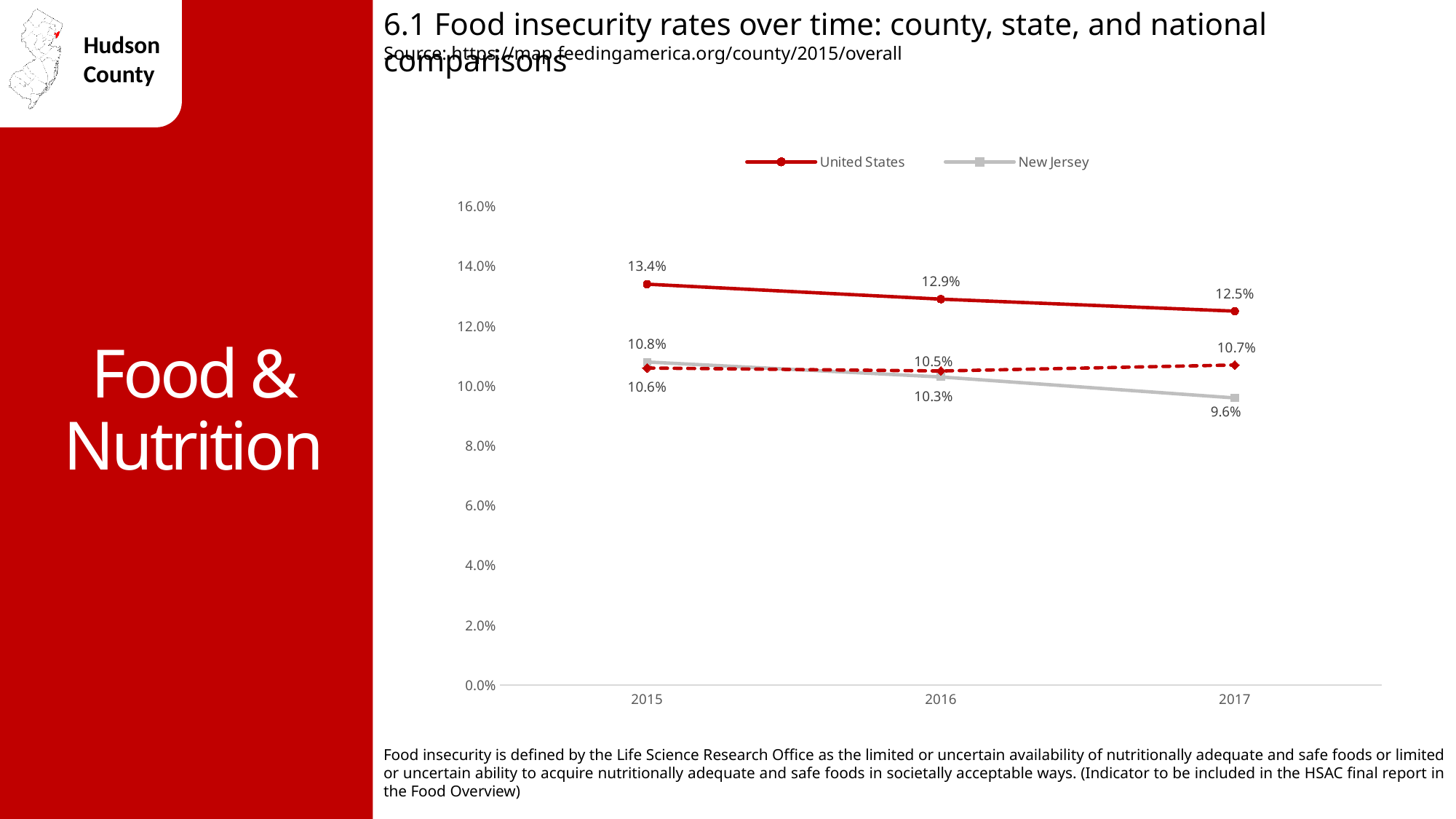
Is the New Jersey value for 2017 greater or less than 10.0%? less What is the New Jersey food insecurity rate in 2017? 9.6% What is the New Jersey food insecurity rate in 2015? 10.8% Does the United States line rise or fall from 2015 to 2017? fall In which year is the United States rate highest? 2015 How many series does the chart legend list? 2 In 2017, which is higher: the United States rate or the New Jersey rate? United States What kind of chart is shown on the slide? line chart How many years are shown on the x axis? 3 What is the United States food insecurity rate in 2017? 12.5% What is the United States food insecurity rate in 2015? 13.4% By how many percentage points did the United States rate change from 2015 to 2017? 0.9 percentage points